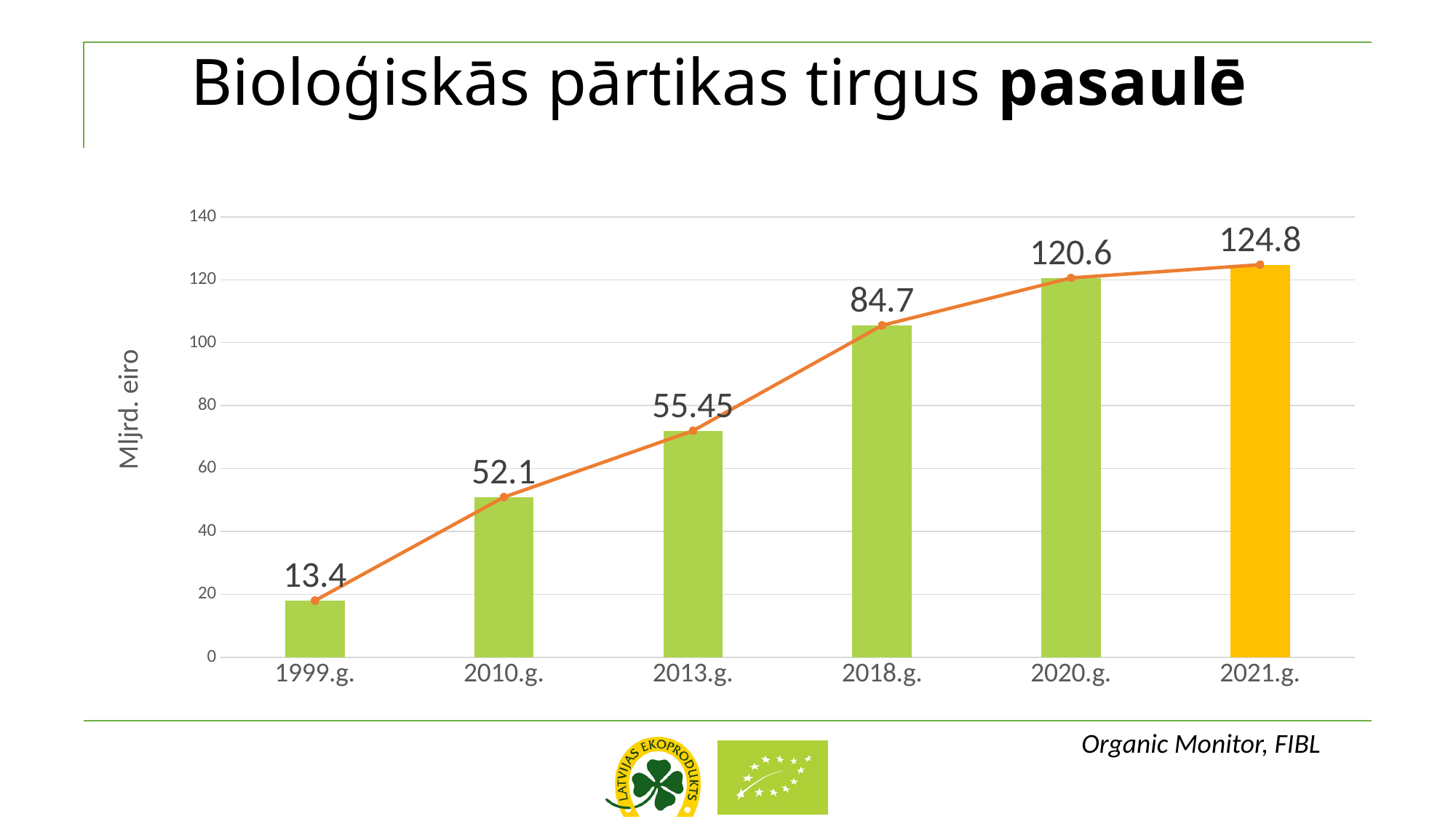
What is the value shown for 2018.g.? 84.7 What is the difference between the values for 2010.g. and 1999.g.? 38.7 What is the value shown for 1999.g.? 13.4 What is the value shown for 2021.g.? 124.8 Which year has the lowest value? 1999.g. How many years are shown on the x axis? 6 What is the difference between the values for 2021.g. and 2020.g.? 4.2 Which year has the highest value? 2021.g. What is the label on the vertical axis? Mljrd. eiro Which is larger, the value for 2018.g. or the value for 2013.g.? 2018.g. What is the value shown for 2013.g.? 55.45 Do the values rise or fall from 1999.g. to 2021.g.? rise